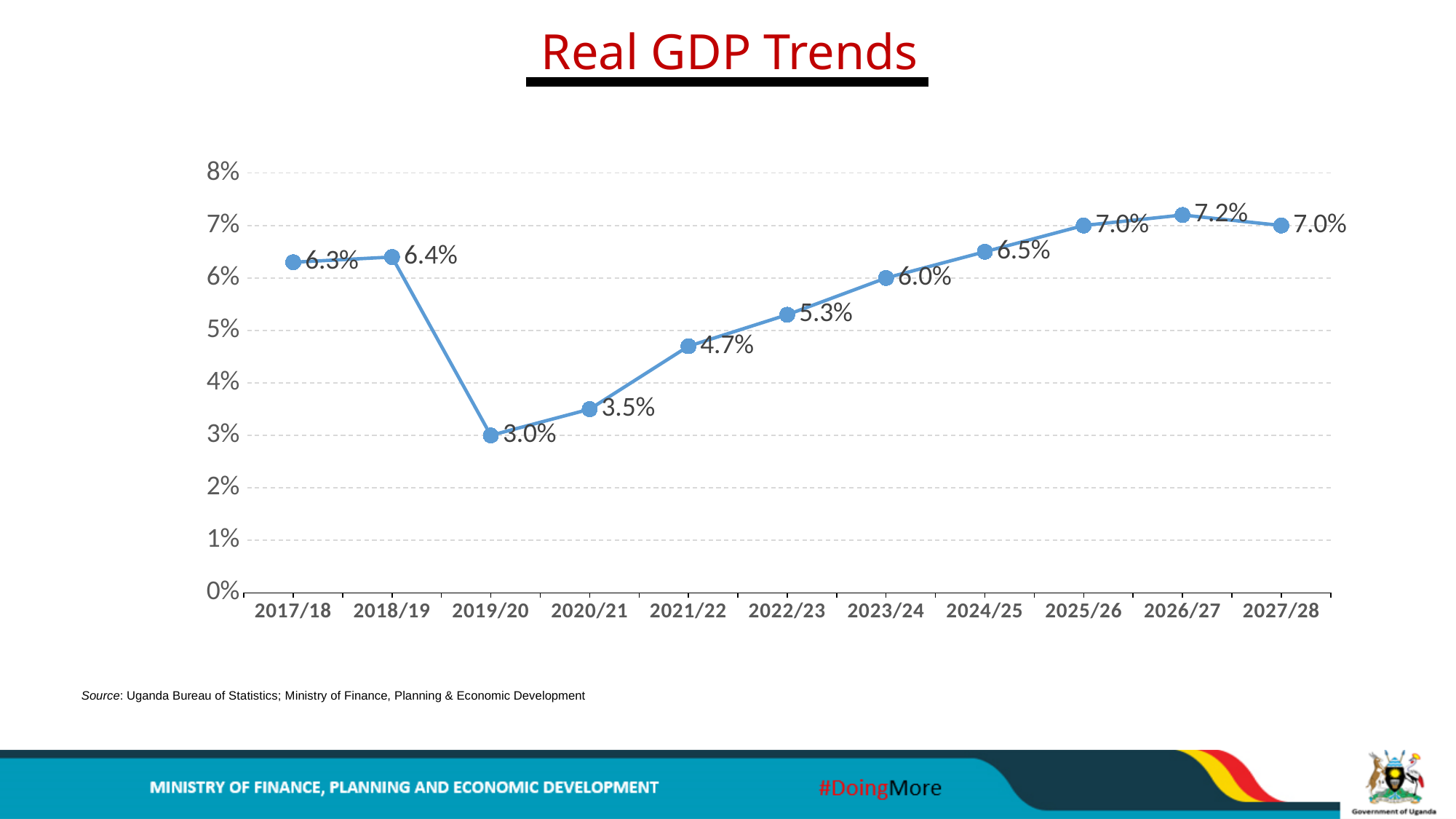
Which year has the highest value on the chart? 2026/27 What is the difference between the values for 2024/25 and 2023/24? 0.5% What is the difference between the values for 2018/19 and 2019/20? 3.4% What is the real GDP growth value for 2019/20? 3.0% Do the values rise or fall from 2019/20 to 2026/27? rise What is the value shown for 2022/23? 5.3% Which is larger, the value for 2020/21 or the value for 2021/22? 2021/22 Is the value for 2025/26 greater or less than 6%? greater What is the value shown for 2026/27? 7.2% Which year has the lowest value on the chart? 2019/20 How many years are plotted on the x axis? 11 What kind of chart is shown on the slide? line chart